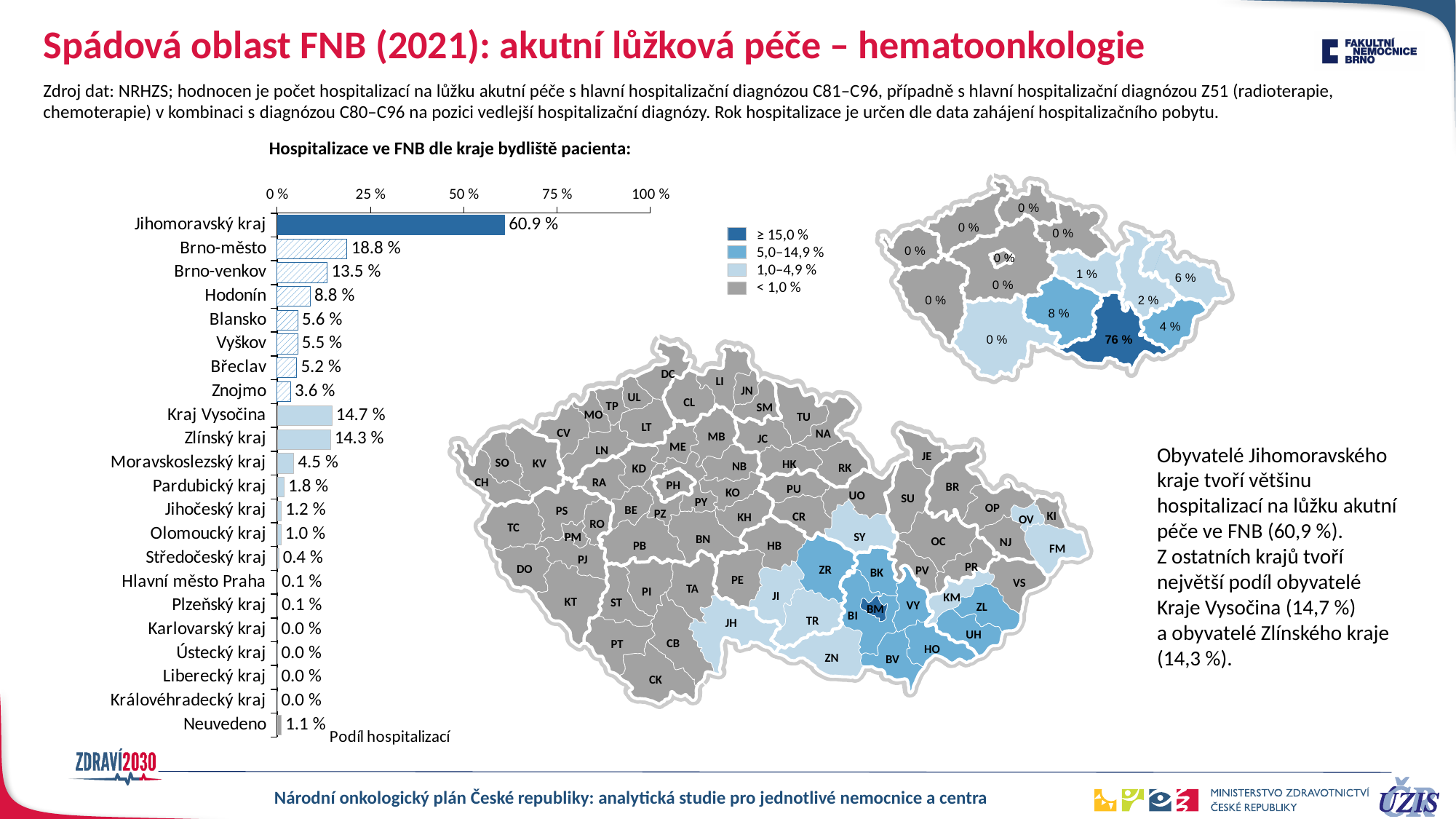
What is the title of the bar chart? Hospitalizace ve FNB dle kraje bydliště pacienta: Which is larger in the bar chart, the value for Blansko or the value for Znojmo? Blansko What is the value for Hodonín in the bar chart? 8.8 % What is the value for Moravskoslezský kraj in the bar chart? 4.5 % What is the difference between the values for Kraj Vysočina and Zlínský kraj in the bar chart? 0.4 % Is the value for Jihomoravský kraj in the bar chart greater or less than 50 %? greater Which category has the highest value in the bar chart? Jihomoravský kraj What is the value for Kraj Vysočina in the bar chart? 14.7 % How many categories are shown in the bar chart? 22 What is the value for Jihomoravský kraj in the bar chart? 60.9 % What kind of chart is used to show hospitalizations by region of residence? bar chart What is the difference between the values for Brno-město and Brno-venkov in the bar chart? 5.3 %